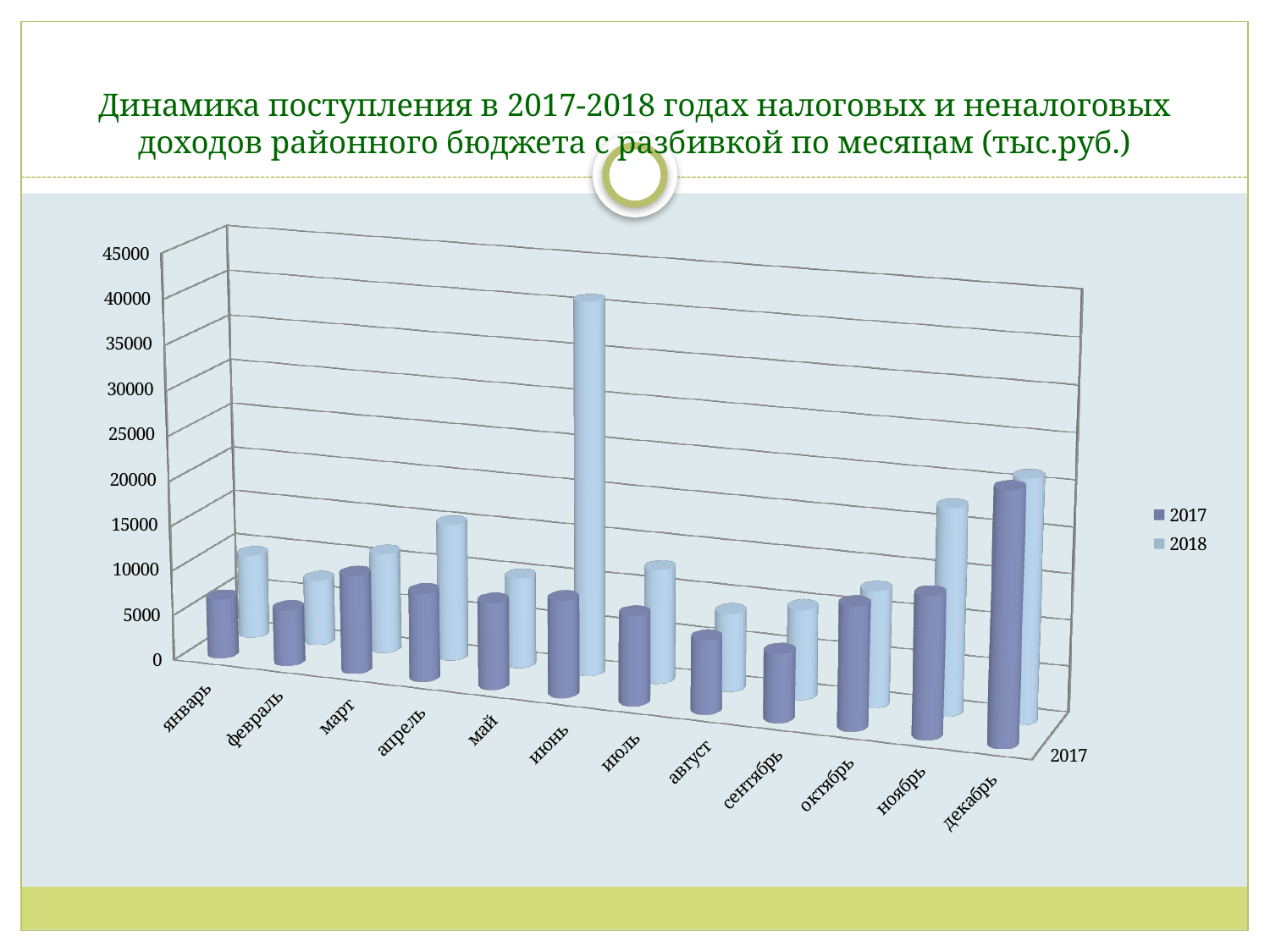
In which month is the 2018 value highest? июнь How many months are shown on the x axis of the chart? 12 For the 2017 series, which month has the larger value, январь or декабрь? декабрь Which series are listed in the legend? 2017 and 2018 For июнь, which series has the larger value, 2017 or 2018? 2018 Do the 2017 values rise or fall from октябрь to декабрь? rise Is the 2018 value for июнь greater or less than 25000? greater In which month is the 2017 value highest? декабрь What kind of chart is shown on the slide? bar chart Is the 2017 value for декабрь greater or less than 10000? greater How many series does the legend list? 2